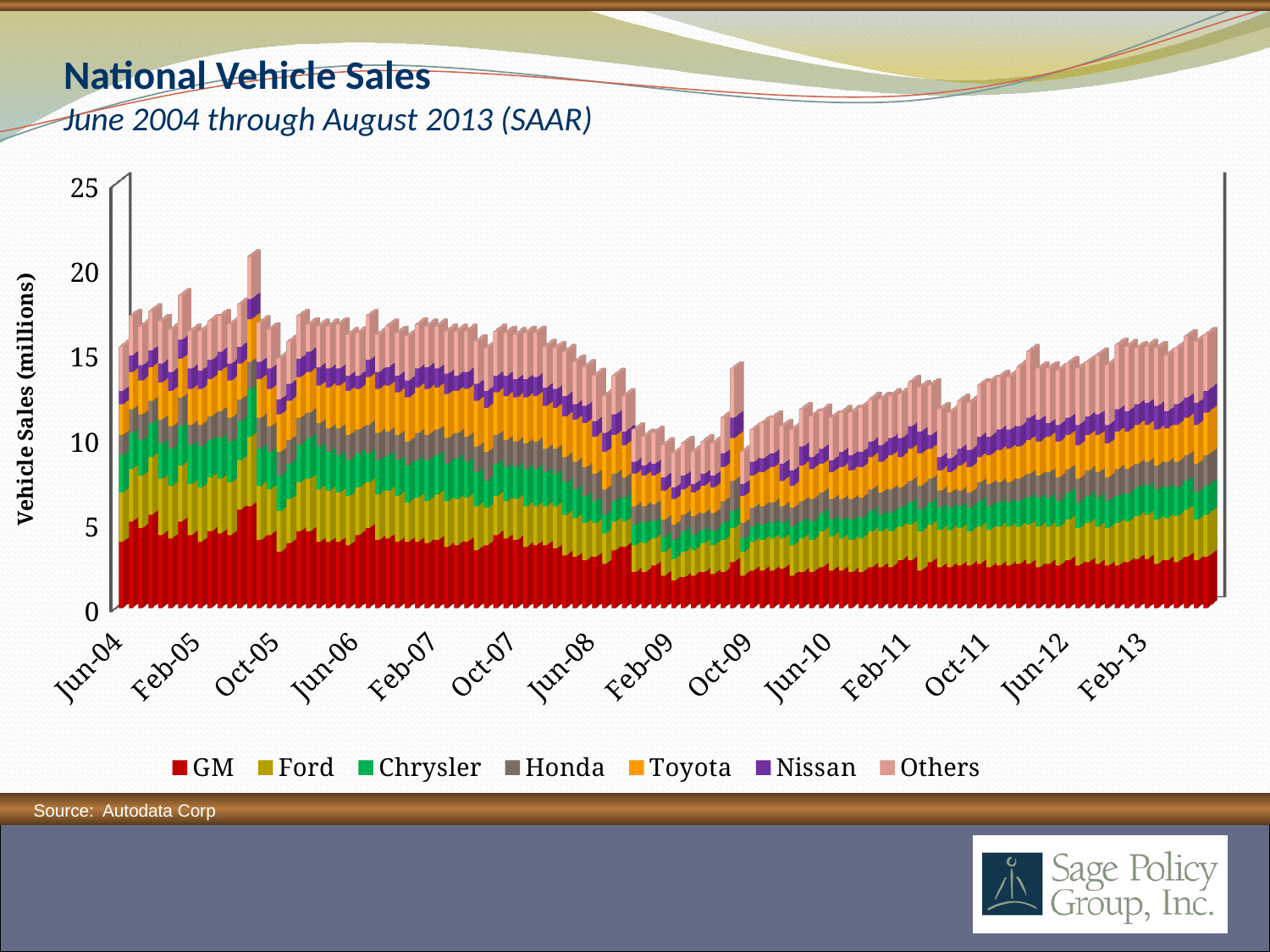
What kind of chart is shown on the slide? Stacked bar chart Is the total vehicle sales value for Feb-09 greater or less than 15? less Which series forms the bottom segment of each stacked bar? GM Do total vehicle sales generally rise or fall from Feb-09 to Feb-13? rise Which series forms the top segment of each stacked bar? Others Do total vehicle sales generally rise or fall from Jun-04 to Feb-09? fall What is the label on the vertical axis? Vehicle Sales (millions) What is the title of the chart? National Vehicle Sales Is the total vehicle sales value for Oct-11 greater or less than 15? less Is the total vehicle sales value for Jun-04 greater or less than 15? greater How many series does the legend list? 7